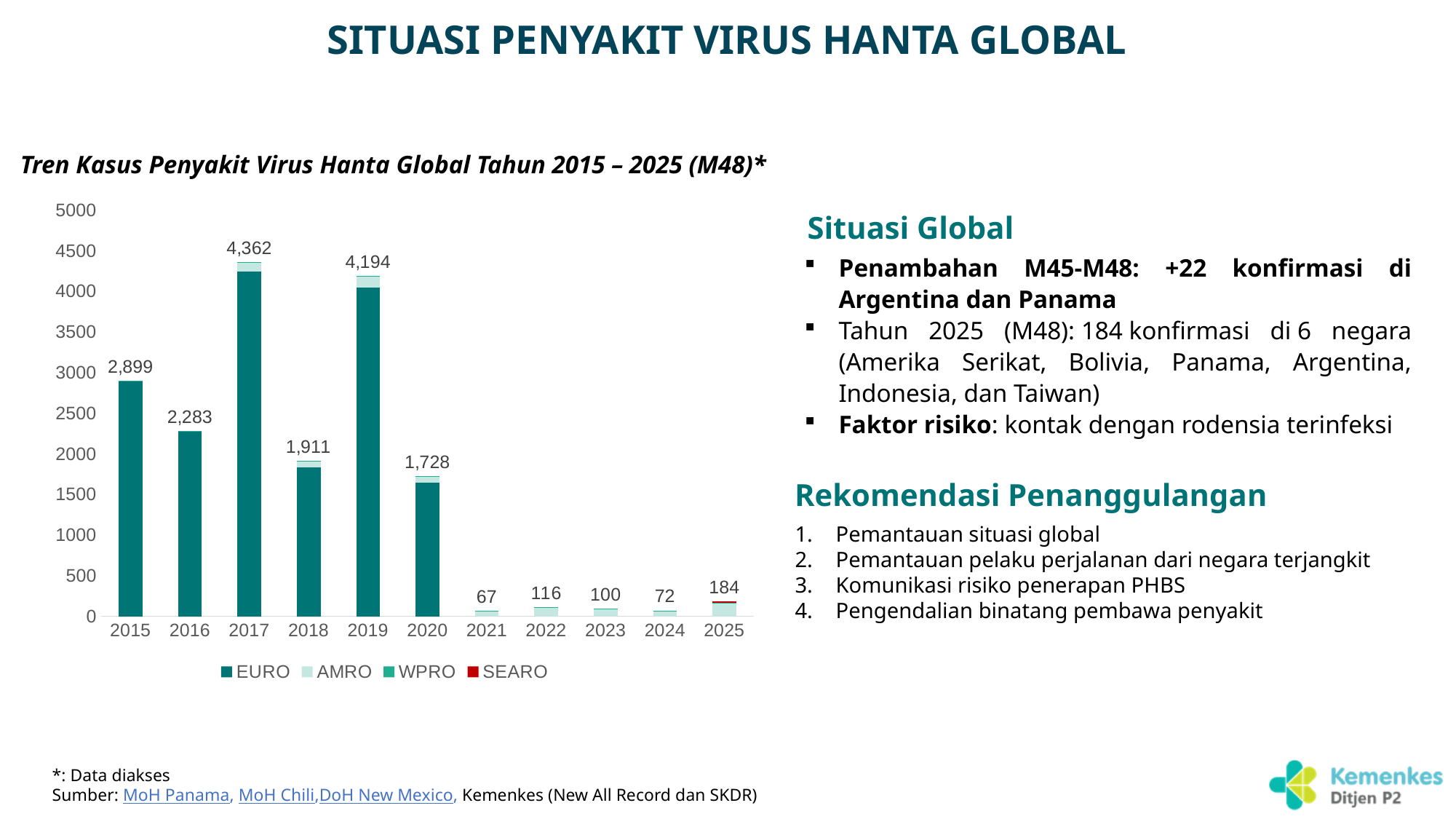
What is the total number of cases shown for 2017? 4,362 Which year has the highest total number of cases? 2017 What is the total number of cases shown for 2020? 1,728 Which year has a larger total, 2015 or 2016? 2015 What kind of chart is shown on the slide? Stacked bar chart Is the EURO value for 2018 greater or less than 2000? less What is the total number of cases shown for 2025? 184 How many years are shown on the x axis? 11 What is the difference between the totals for 2017 and 2019? 168 How many series does the legend list? 4 Do the total values rise or fall from 2019 to 2021? fall Which year has the lowest total number of cases? 2021